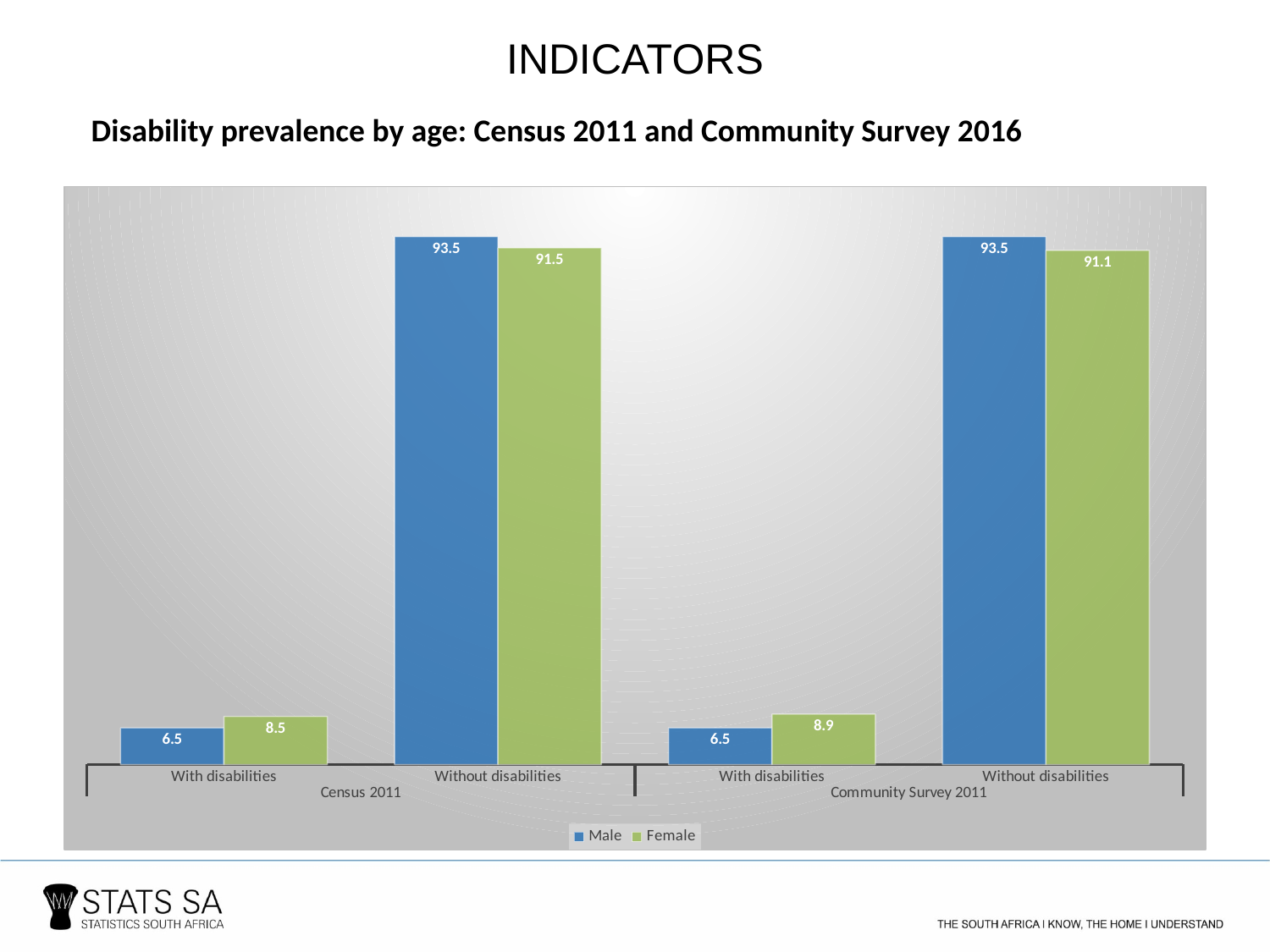
What is the difference between the Female values for 'With disabilities' in Community Survey 2011 and Census 2011? 0.4 Which colour represents the Female series in the chart? Green What is the Male value for 'With disabilities' under Census 2011? 6.5 What kind of chart is shown on the slide? Bar chart Which is larger for 'With disabilities' under Community Survey 2011, the Male or the Female value? Female What is the Female value for 'With disabilities' under Community Survey 2011? 8.9 How many series does the legend list? 2 What is the Female value for 'Without disabilities' under Community Survey 2011? 91.1 What is the Female value for 'Without disabilities' under Census 2011? 91.5 What is the Male value for 'Without disabilities' under Community Survey 2011? 93.5 What is the Female value for 'With disabilities' under Census 2011? 8.5 What is the difference between the Male and Female values for 'Without disabilities' under Census 2011? 2